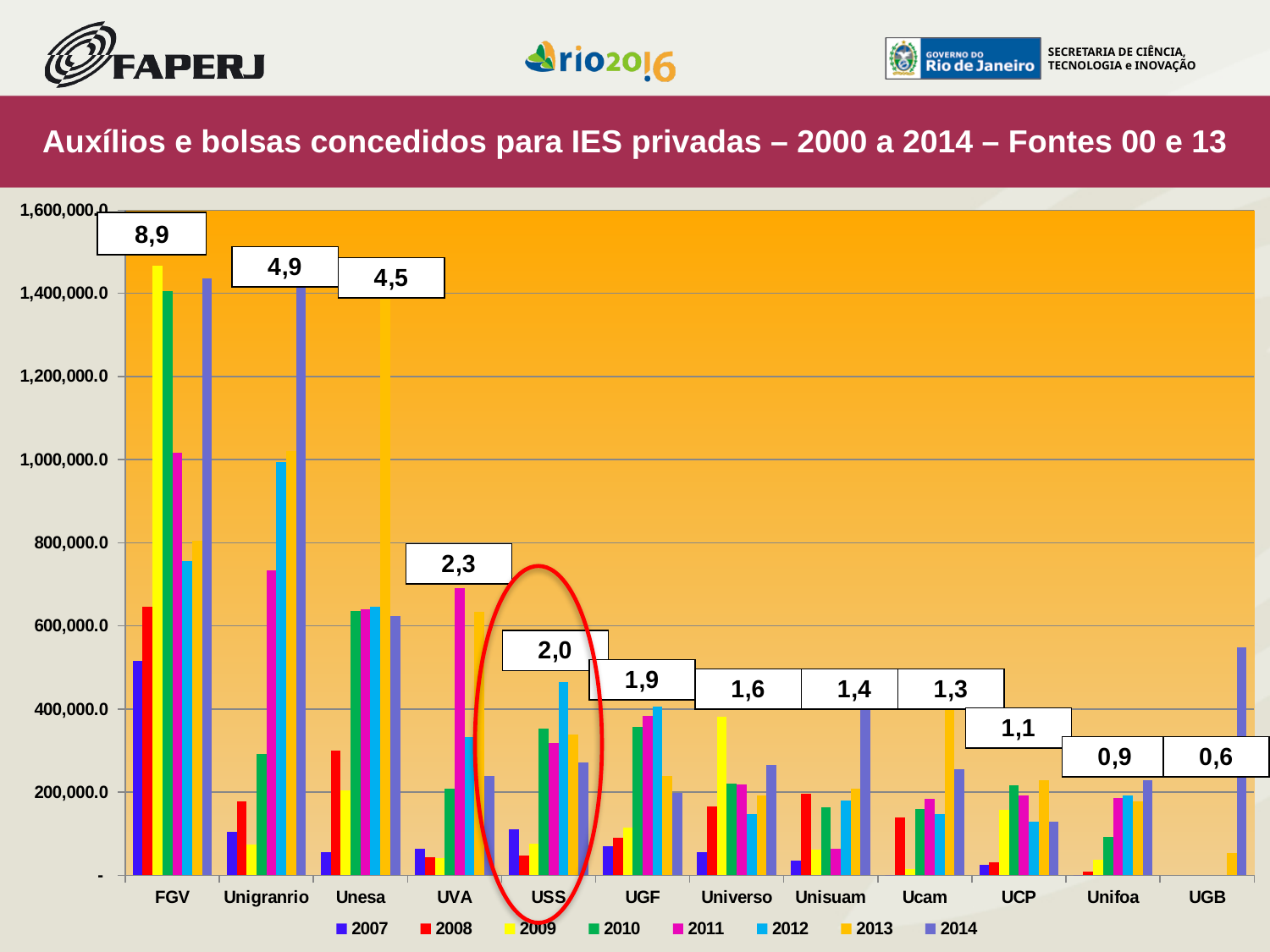
Which year has the highest value for Unigranrio? 2014 Which year has the highest value for Unesa? 2013 What kind of chart is shown on the slide? bar chart Is the value for UGB in 2014 greater or less than 600,000? less Is the value for USS in 2012 greater or less than 400,000? greater What is the title of the chart on the slide? Auxílios e bolsas concedidos para IES privadas – 2000 a 2014 – Fontes 00 e 13 Which is larger, the 2007 value for FGV or the 2007 value for Unigranrio? FGV Which years are the first and last entries in the chart legend? 2007 and 2014 Is the value for UVA in 2011 greater or less than 800,000? less How many series does the chart legend list? 8 How many institutions (categories) are shown on the x axis of the chart? 12